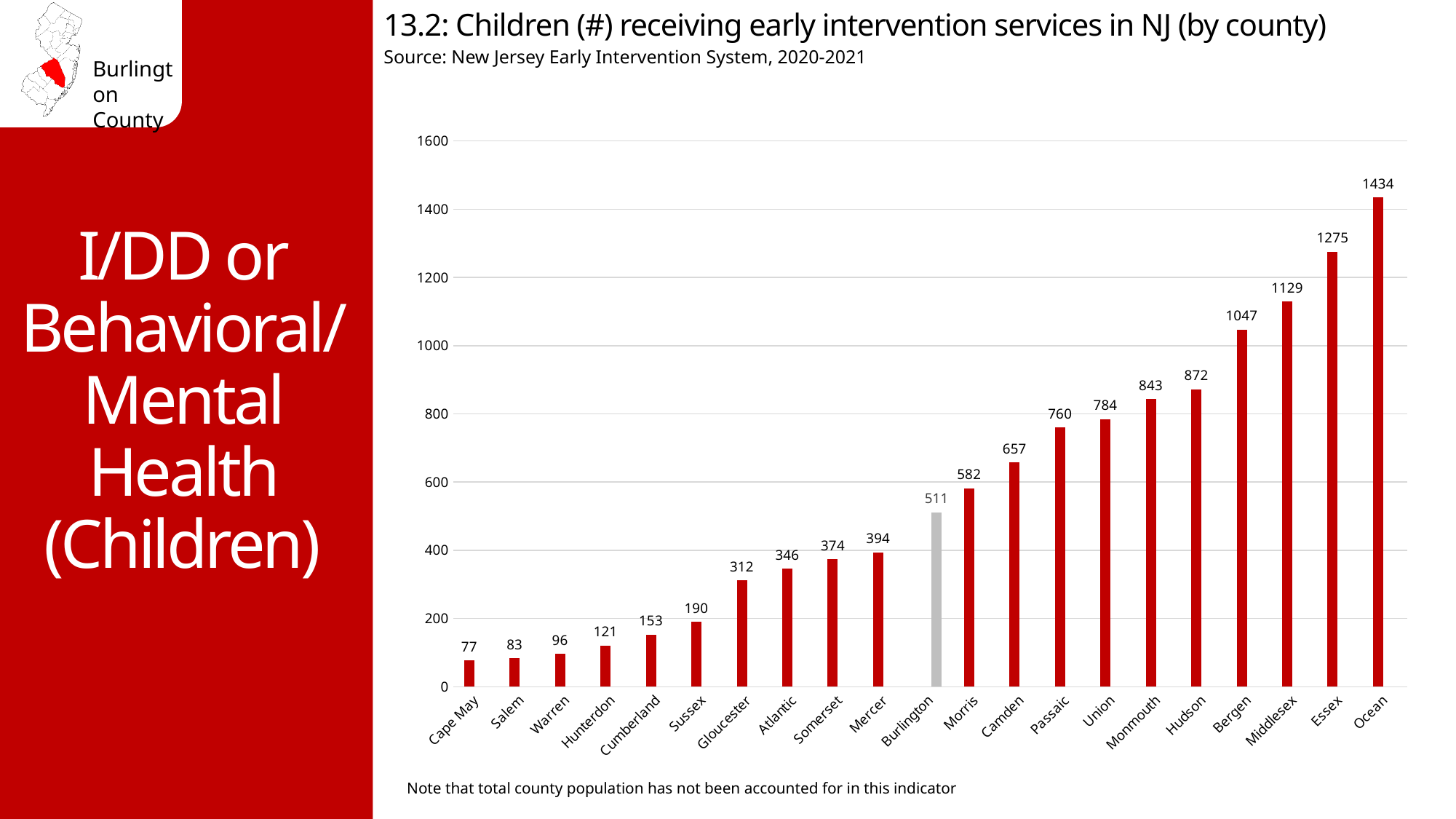
Which county has a larger value, Hudson or Monmouth? Hudson How many counties are shown on the chart? 21 Which county has the highest number of children receiving early intervention services? Ocean What kind of chart is shown on the slide? Bar chart What is the difference between the values for Ocean and Essex? 159 What is the value shown for Camden? 657 How many children received early intervention services in Burlington County? 511 Which county has the lowest number of children receiving early intervention services? Cape May What is the difference between the values for Burlington and Mercer? 117 Is the value for Bergen greater or less than 1000? greater Do the values rise or fall moving from left to right along the x axis? Rise Which county's bar is coloured grey instead of red? Burlington